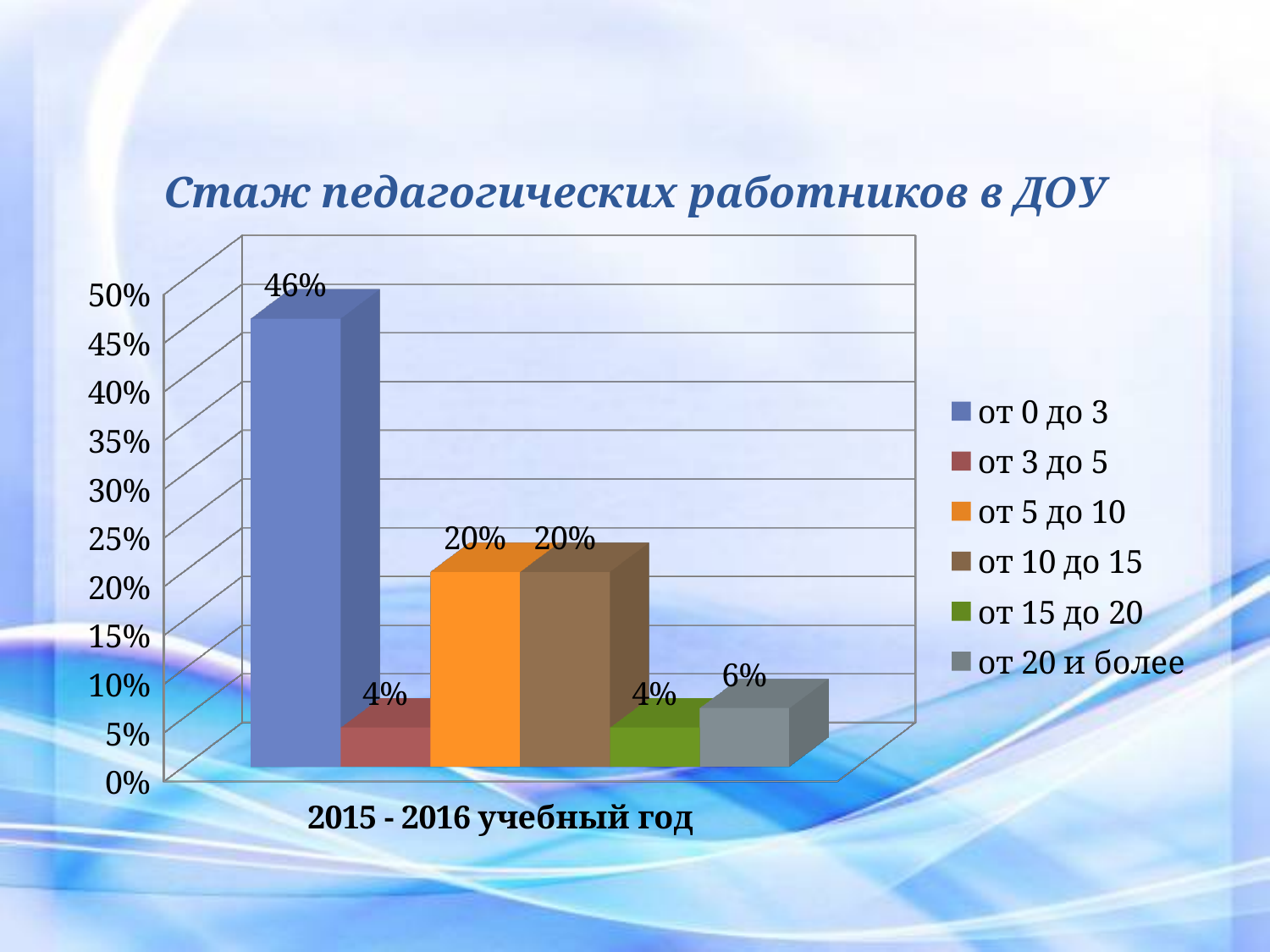
What kind of chart is shown on the slide? bar chart Is the value for "от 0 до 3" greater or less than 40%? greater Which series has the highest value? от 0 до 3 What is the value for the series "от 20 и более"? 6% What is the value for the series "от 0 до 3"? 46% What is the difference between the values for "от 0 до 3" and "от 10 до 15"? 26% What is the difference between the values for "от 20 и более" and "от 15 до 20"? 2% How many series does the legend list? 6 What is the value for the series "от 5 до 10"? 20% What is the category label shown on the x axis? 2015 - 2016 учебный год Which is larger, the value for "от 20 и более" or the value for "от 3 до 5"? от 20 и более What is the title of the chart? Стаж педагогических работников в ДОУ